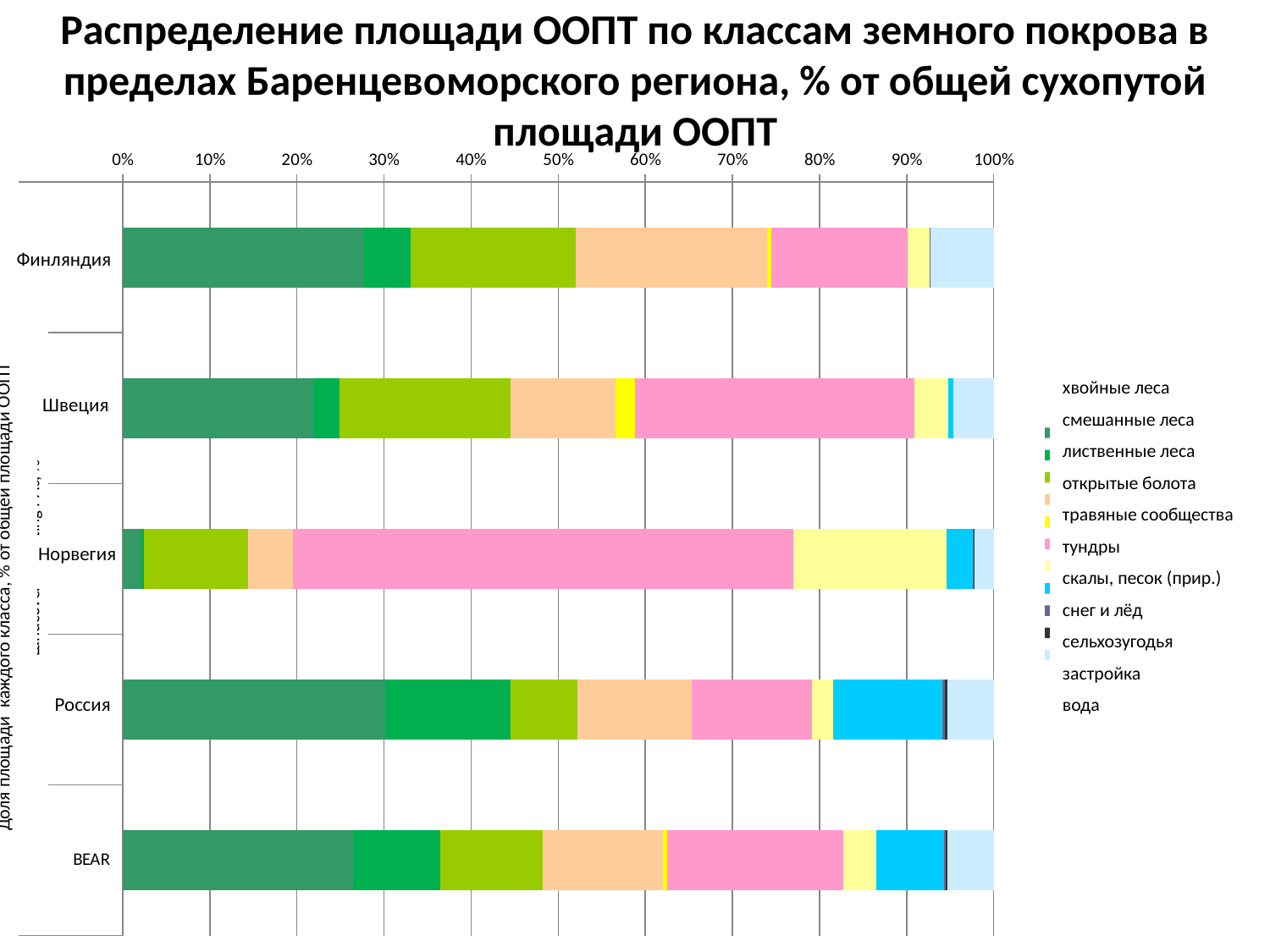
Which has a larger share of хвойные леса, Финляндия or Норвегия? Финляндия Is the share of хвойные леса for Норвегия greater or less than 10%? less How many countries/regions are shown as categories on the vertical axis? 5 Is the share of тундры for Норвегия greater or less than 50%? greater Which has a larger share of тундры, Норвегия or Финляндия? Норвегия What kind of chart is shown on the slide? stacked bar chart Is the share of хвойные леса for Финляндия greater or less than 20%? greater Which category has the largest share of тундры? Норвегия How many land cover classes does the legend list? 11 What is the last category listed at the bottom of the vertical axis? BEAR Which category has the smallest share of хвойные леса? Норвегия Which category has the largest share of скалы, песок (прир.)? Норвегия